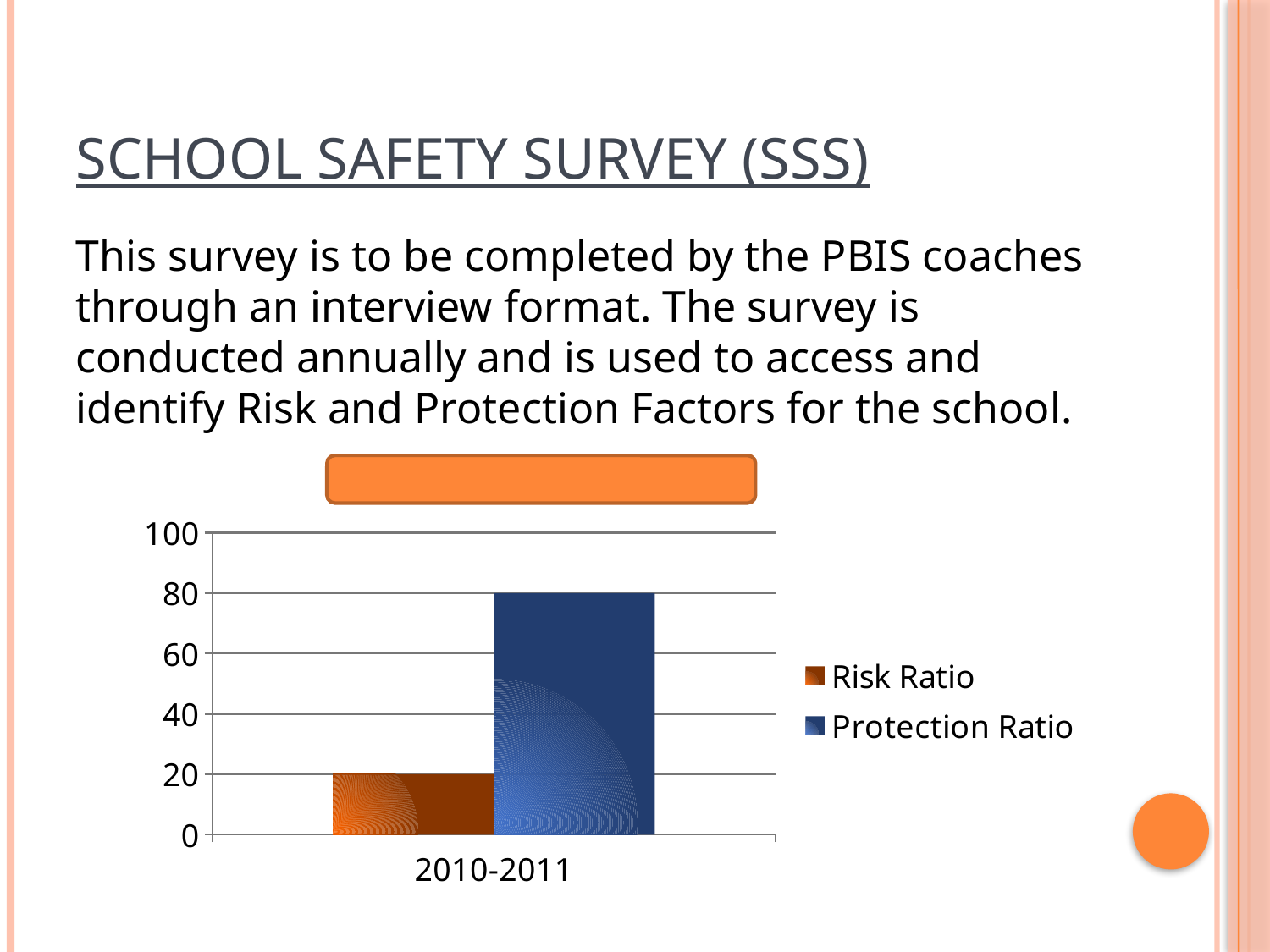
What is the difference between the Protection Ratio and the Risk Ratio for 2010-2011? 60 Which series has the higher value for 2010-2011, Risk Ratio or Protection Ratio? Protection Ratio What is the Risk Ratio value for 2010-2011? 20 Which series has the lowest value in the chart? Risk Ratio How many categories are shown on the x axis of the chart? 1 What colour are the Protection Ratio bars in the chart? blue How many series does the chart legend list? 2 What is the Protection Ratio value for 2010-2011? 80 What kind of chart is shown on the slide? bar chart Is the Protection Ratio value for 2010-2011 greater or less than 60? greater What is the maximum value shown on the chart's vertical axis? 100 Is the Risk Ratio value for 2010-2011 greater or less than 40? less